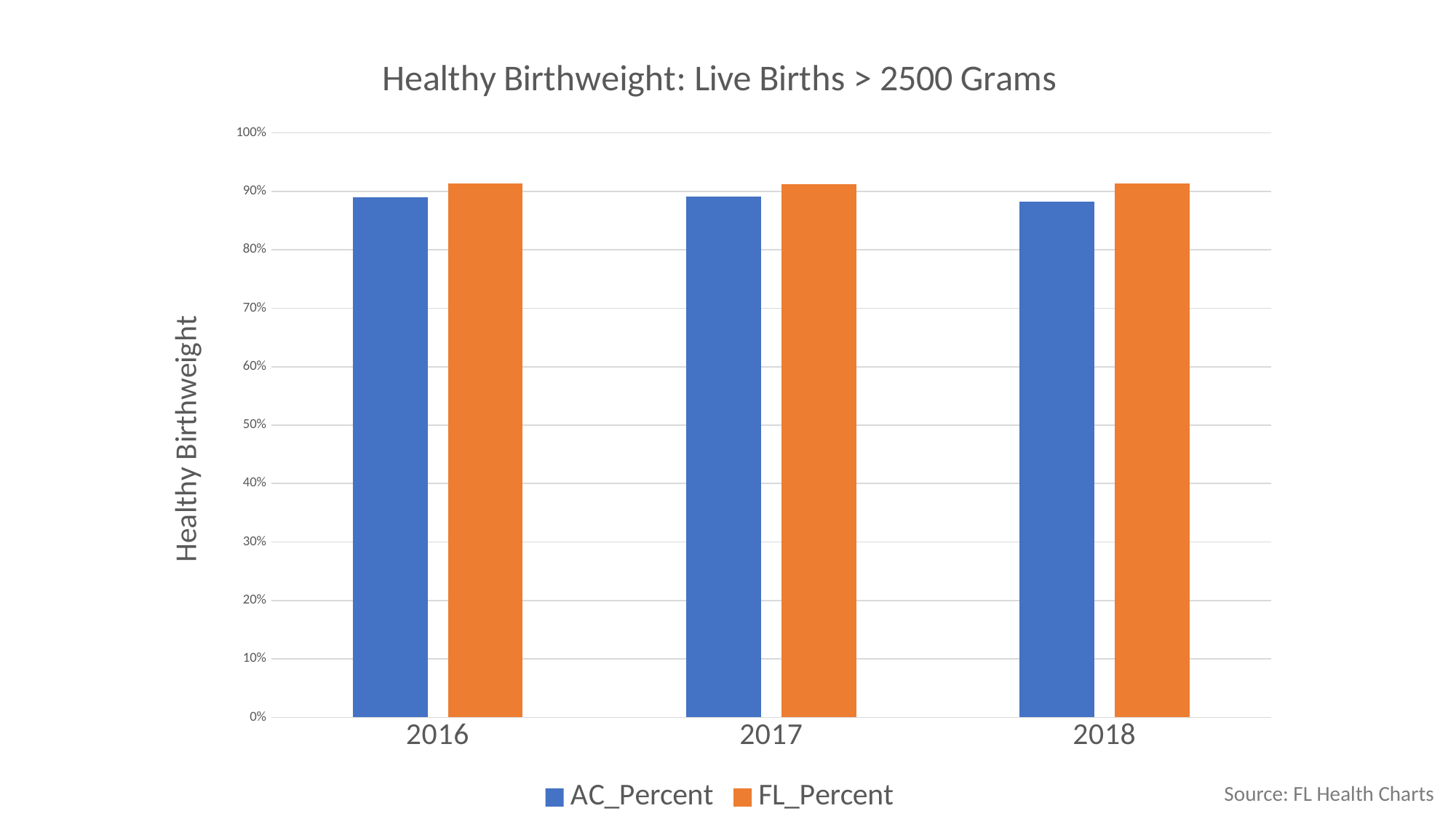
Is the value for AC_Percent in 2018 greater or less than 90%? less In 2016, which series has the higher value, AC_Percent or FL_Percent? FL_Percent In 2018, which series has the higher value, AC_Percent or FL_Percent? FL_Percent How many series does the chart's legend list? 2 What is the title of the chart? Healthy Birthweight: Live Births > 2500 Grams Is the value for AC_Percent in 2017 greater or less than 80%? greater What is the label on the vertical axis of the chart? Healthy Birthweight Is the value for FL_Percent in 2018 greater or less than 90%? greater In 2017, which series has the higher value, AC_Percent or FL_Percent? FL_Percent How many years are shown on the x axis of the chart? 3 What kind of chart is shown on the slide? bar chart